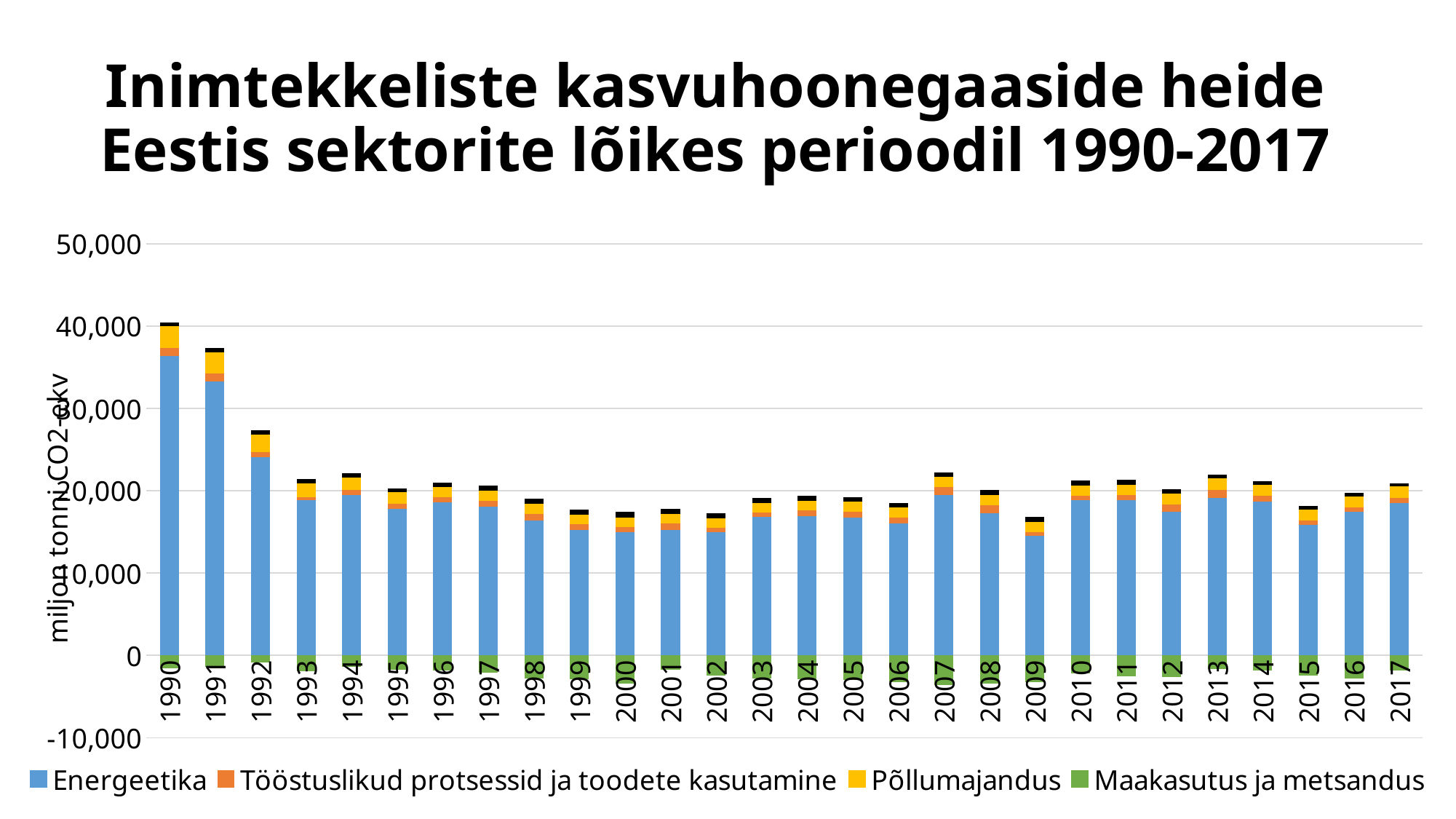
Is the total stacked value above zero for 2009 greater or less than 20,000? less How many series does the legend list? 4 How many years are shown on the x axis of the chart? 28 Which series is shown in green in the legend? Maakasutus ja metsandus What kind of chart is shown on the slide? stacked bar chart Is the Energeetika value for 1990 greater or less than 30,000? greater Which year has the highest Energeetika value? 1990 Which year has the larger Energeetika value, 1990 or 1991? 1990 Is the Energeetika value for 1999 greater or less than 20,000? less Do the Energeetika values rise or fall from 1990 to 1993? fall Which year has the larger Energeetika value, 2007 or 2009? 2007